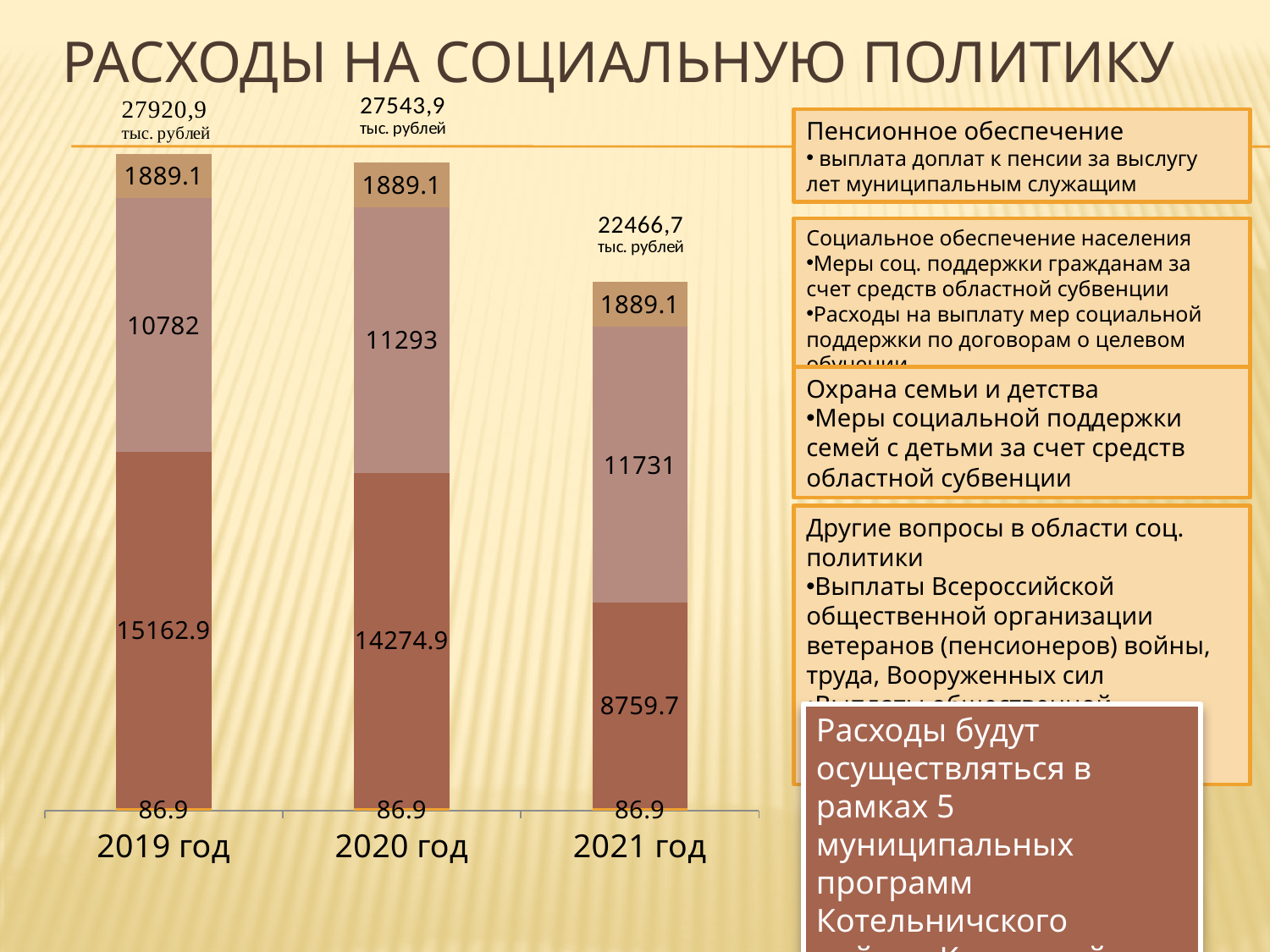
What is the value of the largest (dark brown) segment in the 2020 год bar? 14274.9 Which year has the highest total expenditure? 2019 год Which year has the lowest total expenditure? 2021 год Which year has the larger value for the second segment from the top: 2019 год or 2020 год? 2020 год What kind of chart is shown on the slide? stacked bar chart How many years (bars) are shown on the chart? 3 What is the value of the topmost segment in each bar? 1889.1 What total is printed above the bar for 2019 год? 27920,9 тыс. рублей What is the value of the bottom segment in the 2019 год bar? 86.9 What total is printed above the bar for 2021 год? 22466,7 тыс. рублей What is the difference between the largest (dark brown) segment in 2019 год and in 2021 год? 6403.2 What is the value of the second segment from the top in the 2021 год bar? 11731